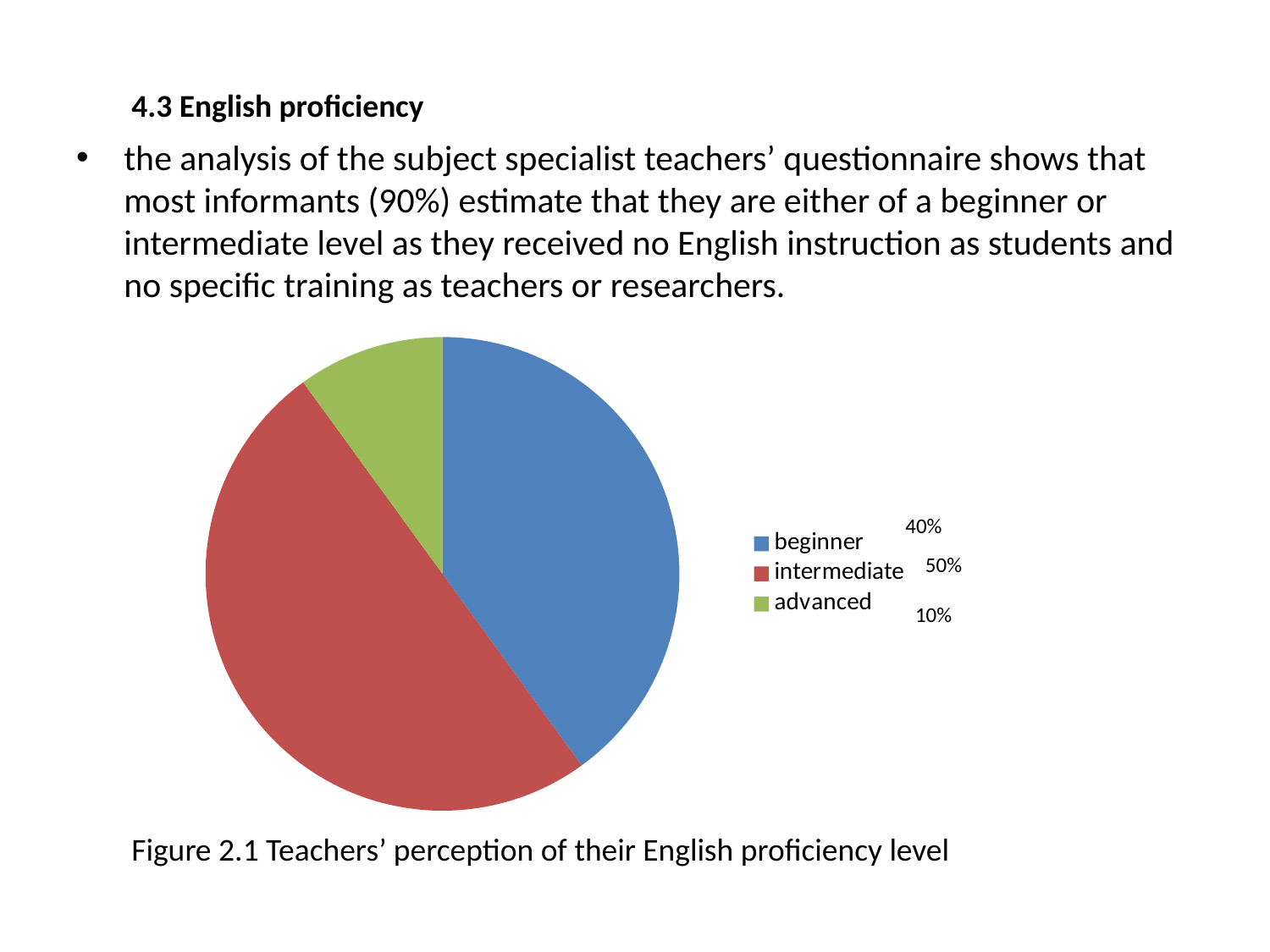
What colour represents the intermediate category in the pie chart? red Which is larger, the beginner share or the advanced share? beginner What is the caption of the figure below the pie chart? Figure 2.1 Teachers' perception of their English proficiency level What is the combined share of beginner and intermediate teachers? 90% What kind of chart is shown on the slide? pie chart How many categories does the pie chart have? 3 What percentage of teachers rated themselves as advanced? 10% What percentage of teachers rated themselves as intermediate? 50% Which proficiency level has the smallest share of the pie? advanced What percentage of teachers rated themselves as beginner? 40% What is the difference in percentage points between the intermediate and beginner shares? 10 Which proficiency level has the largest share of the pie? intermediate